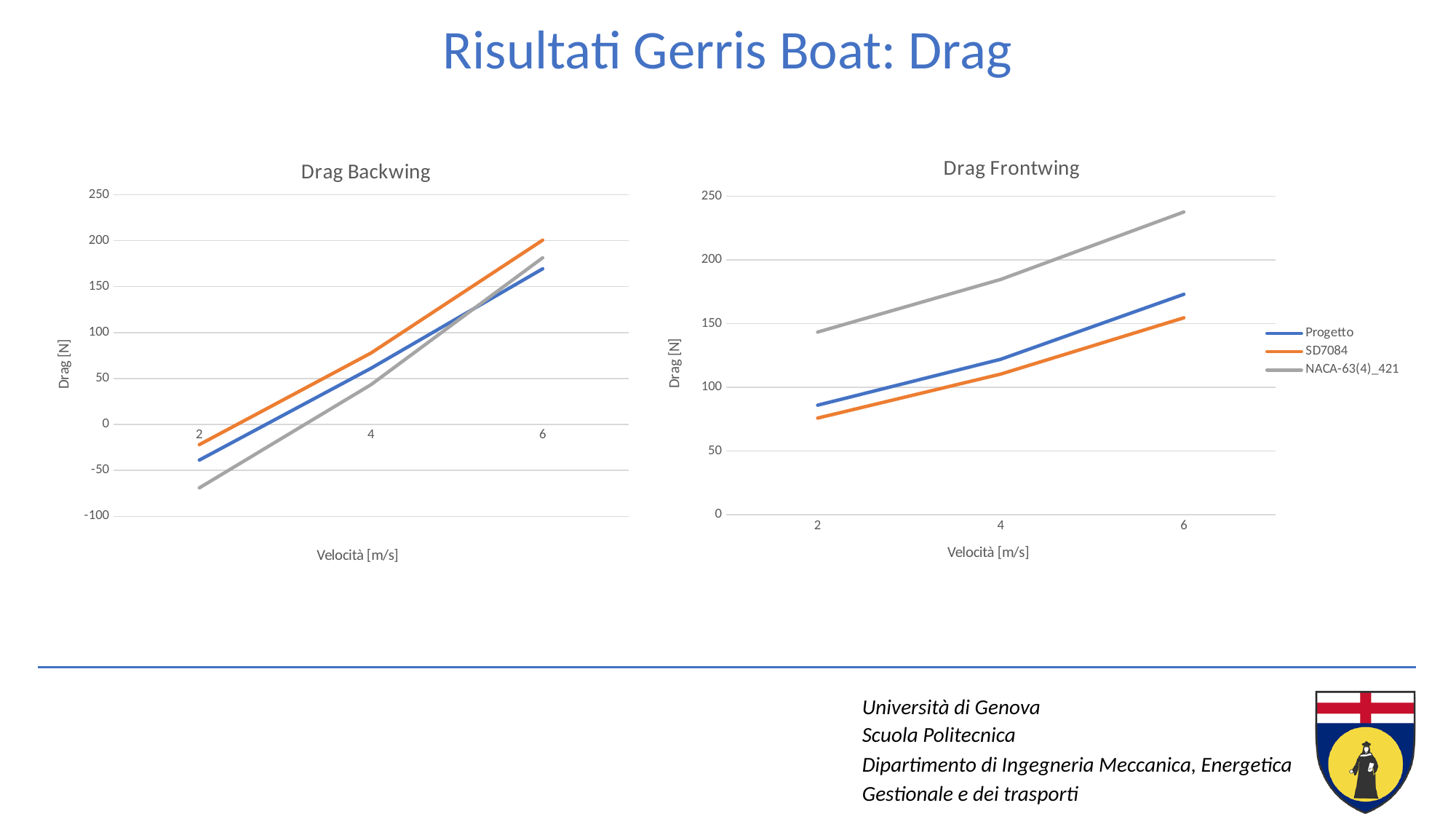
What kind of chart is the Drag Backwing chart? line chart In the Drag Frontwing chart, which series has the highest drag at a velocity of 6 m/s? NACA-63(4)_421 In the Drag Backwing chart, which series has the lowest drag at a velocity of 2 m/s? NACA-63(4)_421 What is the label of the y axis on the Drag Frontwing chart? Drag [N] How many series does the legend list for the Drag Frontwing chart? 3 In the Drag Backwing chart, is the value for NACA-63(4)_421 at 2 m/s greater or less than -50? less In the Drag Backwing chart, is the value for SD7084 at 6 m/s greater or less than 150? greater In the Drag Frontwing chart, which series has the lowest drag at a velocity of 2 m/s? SD7084 In the Drag Frontwing chart, is the value for Progetto at 2 m/s greater or less than 100? less In the Drag Frontwing chart, do the values for NACA-63(4)_421 rise or fall as velocity increases? rise In the Drag Backwing chart, which series has the highest drag at a velocity of 6 m/s? SD7084 How many velocity points are plotted along the x axis of the Drag Backwing chart? 3